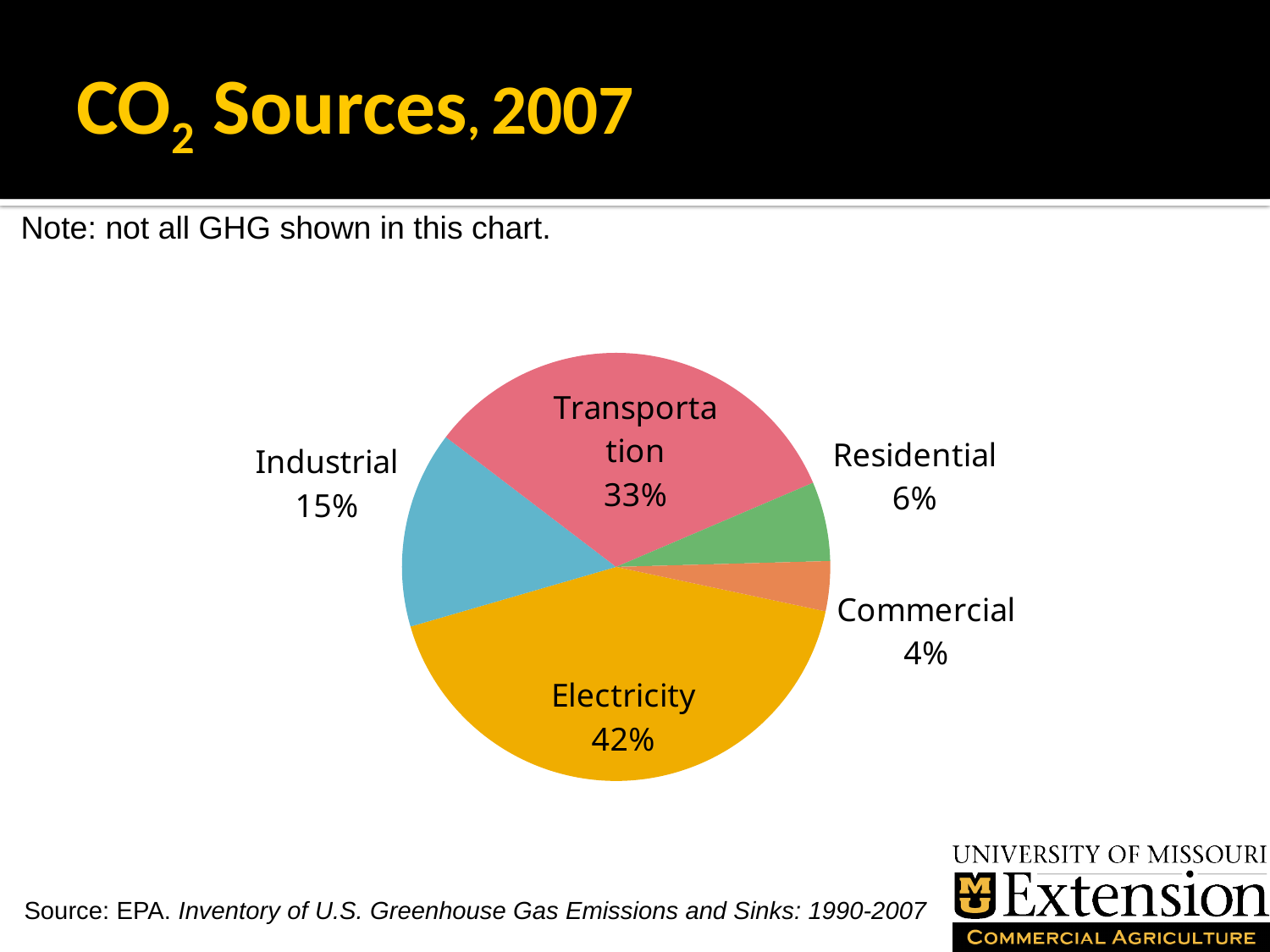
What share of CO2 sources does Industrial account for? 15% What share of CO2 sources does Transportation account for? 33% What share of CO2 sources does Electricity account for? 42% Which is larger, the Industrial share or the Residential share? Industrial Which source has the smallest share of the pie? Commercial What kind of chart is shown on the slide? pie chart What is the difference in percentage points between Electricity and Transportation? 9 How many slices does the pie chart have? 5 Which source has the largest share of the pie? Electricity What colour is the Electricity slice? yellow